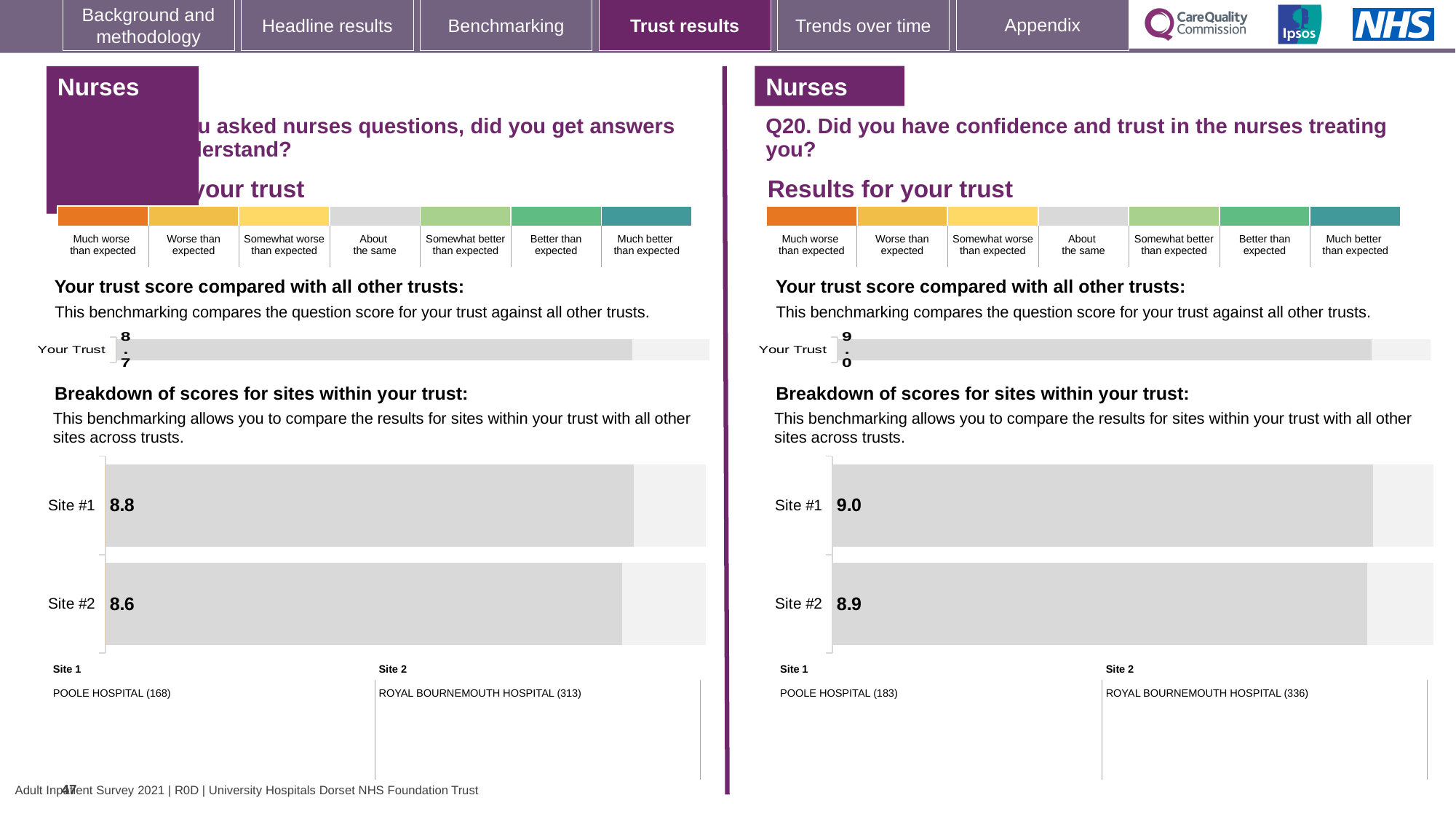
On the right-hand site breakdown chart for Q20, which site has the lower score? Site #2 On the right-hand 'Your trust score compared with all other trusts' chart for Q20, what is the score shown for Your Trust? 9.0 On the left-hand 'Breakdown of scores for sites within your trust' chart, what is the score for Site #2? 8.6 On the left-hand site breakdown chart, what is the difference between the Site #1 and Site #2 scores? 0.2 On the right-hand chart for Q20 (confidence and trust in the nurses), what is the score for Site #1? 9.0 On the left-hand site breakdown chart, which site has the higher score? Site #1 On the left-hand 'Your trust score compared with all other trusts' chart, what is the score shown for Your Trust? 8.7 What type of chart is used for the site breakdown on the left-hand side of the slide? Bar chart How many sites are shown on the right-hand site breakdown chart for Q20? 2 On the right-hand site breakdown chart for Q20, what is the difference between the Site #1 and Site #2 scores? 0.1 On the left-hand 'Breakdown of scores for sites within your trust' chart, what is the score for Site #1? 8.8 On the right-hand chart for Q20 (confidence and trust in the nurses), what is the score for Site #2? 8.9